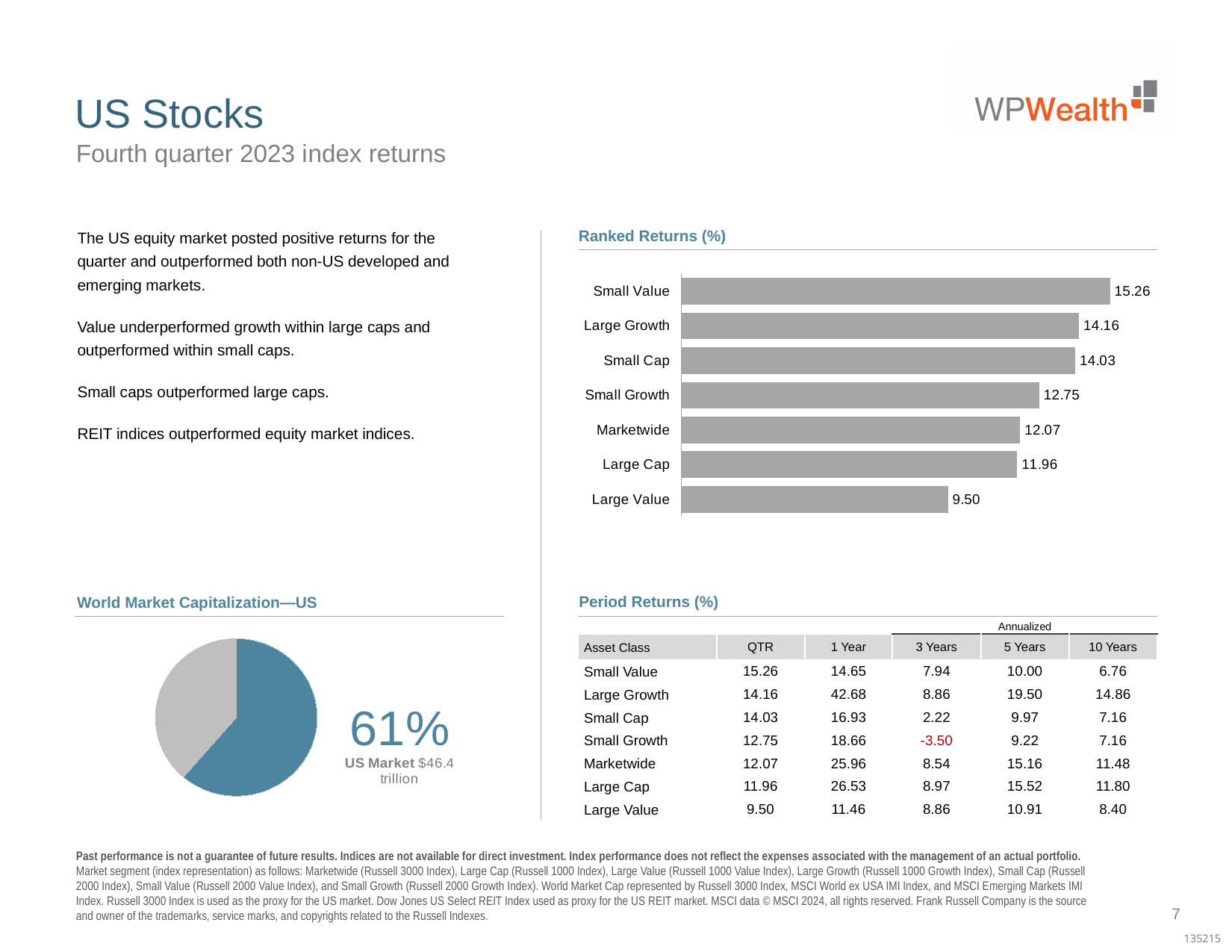
What kind of chart is the World Market Capitalization—US chart? Pie chart In the Ranked Returns (%) chart, which category has the highest value? Small Value In the World Market Capitalization—US chart, what share of the pie does the US market represent? 61% What kind of chart is the Ranked Returns (%) chart? Bar chart In the Ranked Returns (%) chart, what is the value for Large Value? 9.50 In the Ranked Returns (%) chart, what is the value for Marketwide? 12.07 In the Ranked Returns (%) chart, what is the value for Small Value? 15.26 In the Ranked Returns (%) chart, which category has the lowest value? Large Value In the Ranked Returns (%) chart, what is the difference between Small Value and Large Value? 5.76 How many categories are shown in the Ranked Returns (%) chart? 7 In the Ranked Returns (%) chart, which is larger, Small Growth or Large Cap? Small Growth In the Ranked Returns (%) chart, what is the difference between Large Growth and Small Cap? 0.13